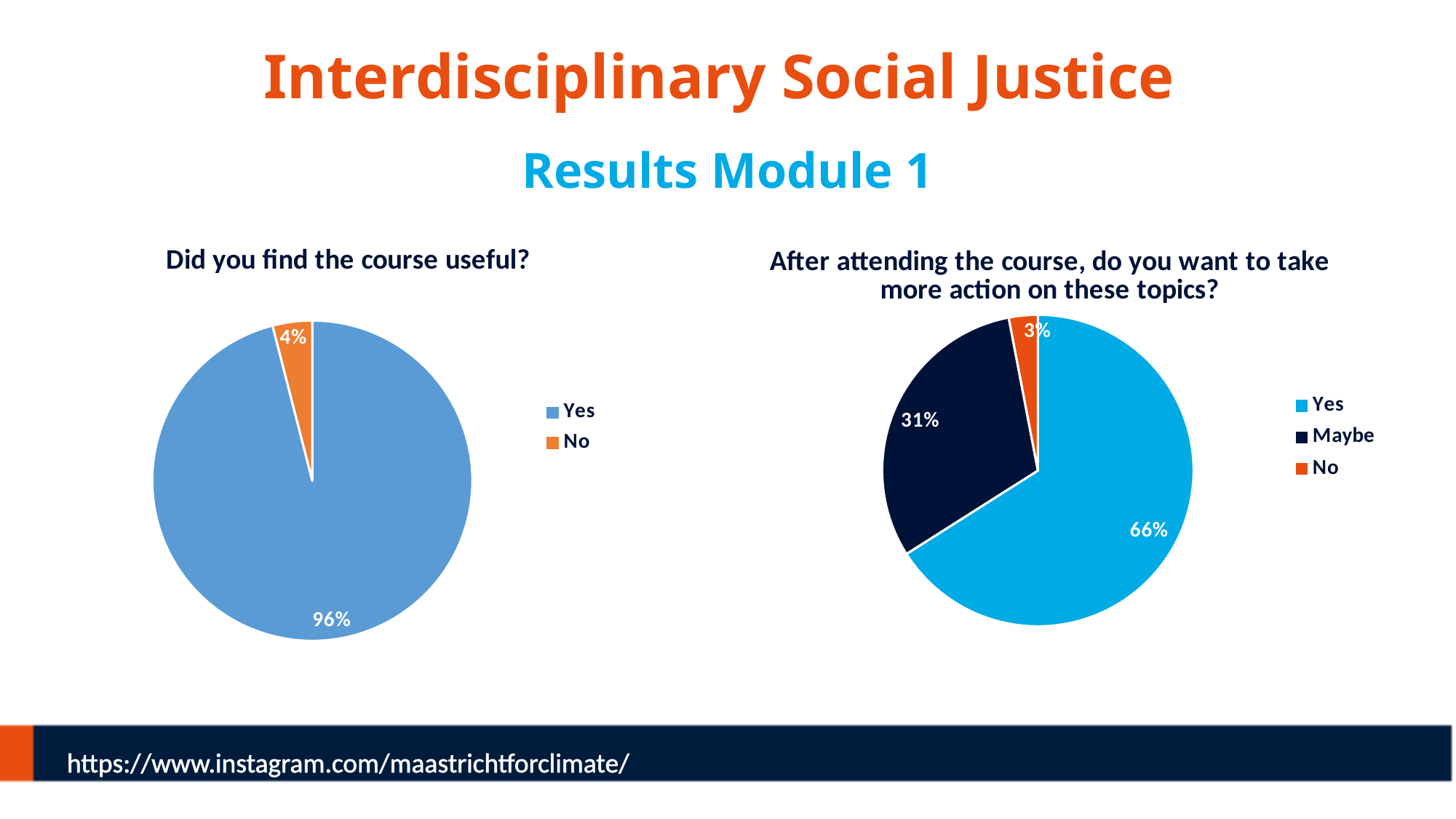
How many categories does the legend of the right-hand chart list? 3 What kind of chart is 'Did you find the course useful?'? Pie chart In the right-hand chart, what colour is the Maybe slice? Dark navy blue In the 'Did you find the course useful?' chart, what share of respondents answered No? 4% In the 'After attending the course, do you want to take more action on these topics?' chart, what share answered Yes? 66% In the left-hand chart, what is the difference in percentage points between the Yes and No shares? 92 In the right-hand chart, which response has the largest share? Yes In the 'After attending the course, do you want to take more action on these topics?' chart, what share answered Maybe? 31% In the right-hand chart, what is the difference in percentage points between the Yes and Maybe shares? 35 In the 'After attending the course, do you want to take more action on these topics?' chart, what share answered No? 3% In the 'Did you find the course useful?' chart, what share of respondents answered Yes? 96% In the right-hand chart, which response has the smallest share? No